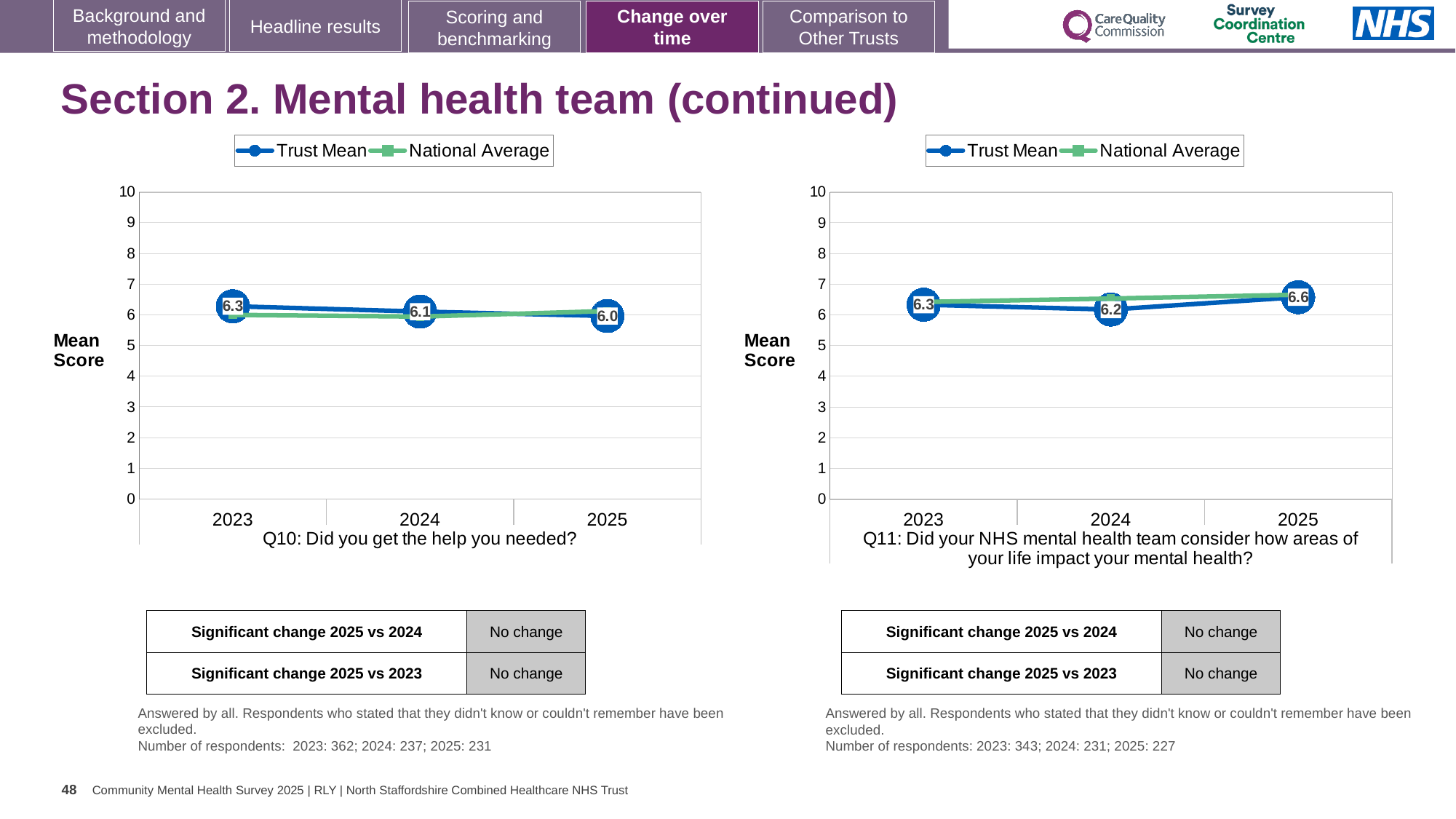
In the Q11 chart (right), what is the Trust Mean score for 2024? 6.2 In the Q11 chart (right), which year has the highest Trust Mean score? 2025 In the Q10 chart (left), which year has the lowest Trust Mean score? 2025 In the Q11 chart (right), what is the difference between the Trust Mean scores for 2025 and 2024? 0.4 In the Q10 chart (left), does the Trust Mean rise or fall from 2023 to 2025? fall How many series does the legend of the Q10 chart (left) list? 2 What type of chart is used for Q10 (left)? line chart How many years are plotted on the x axis of the Q11 chart (right)? 3 In the Q10 chart (left), what is the Trust Mean score for 2023? 6.3 In the Q10 chart (left), what is the difference between the Trust Mean scores for 2023 and 2025? 0.3 In the Q10 chart (left), what is the Trust Mean score for 2025? 6.0 In the Q11 chart (right), what is the Trust Mean score for 2025? 6.6